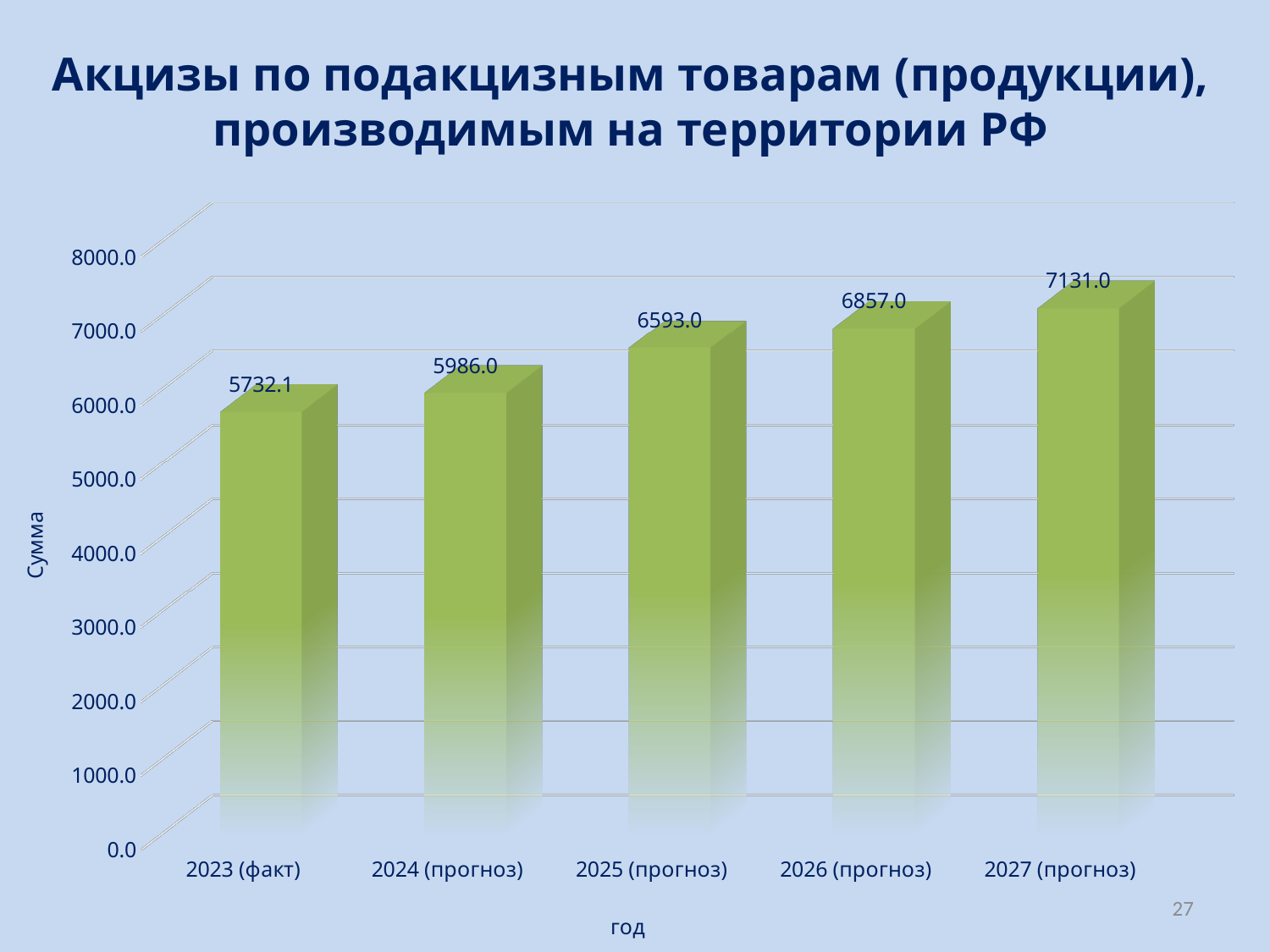
Which year has the lowest value? 2023 (факт) How many years are shown on the x axis? 5 Do the values rise or fall from 2023 to 2027? rise What is the difference between the values for 2024 (прогноз) and 2023 (факт)? 253.9 What kind of chart is this? bar chart What is the value for 2027 (прогноз)? 7131.0 Which is larger, the value for 2024 (прогноз) or the value for 2026 (прогноз)? 2026 (прогноз) Which year has the highest value? 2027 (прогноз) What is the value for 2023 (факт)? 5732.1 What is the value for 2025 (прогноз)? 6593.0 Is the value for 2025 (прогноз) greater or less than 6000.0? greater What is the difference between the values for 2027 (прогноз) and 2026 (прогноз)? 274.0